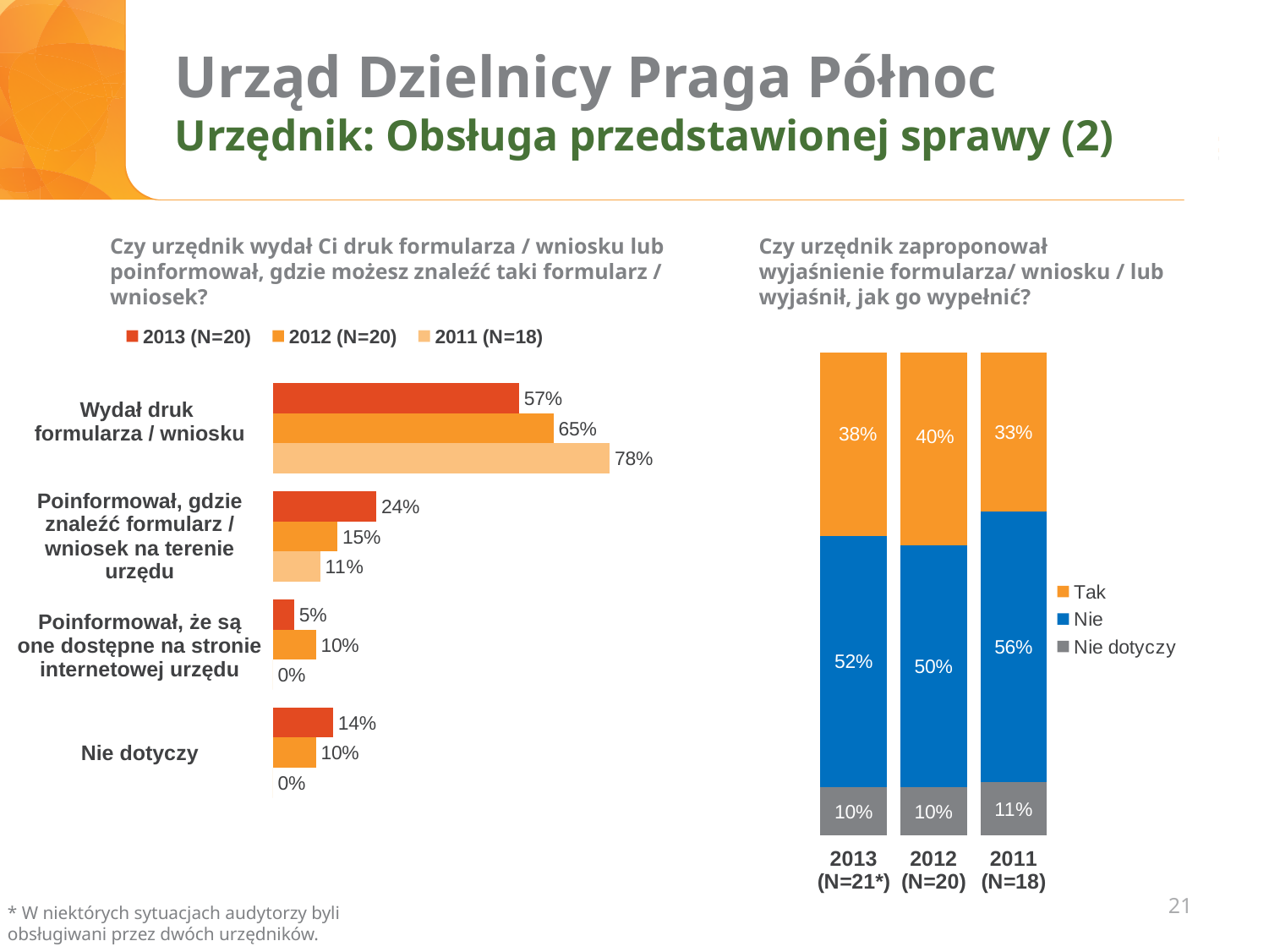
In the left chart, what is the 2012 (N=20) value for "Nie dotyczy"? 10% In the left chart, which category has the highest 2013 (N=20) value? Wydał druk formularza / wniosku In the left chart, what is the difference between the 2011 (N=18) and 2013 (N=20) values for "Wydał druk formularza / wniosku"? 21% In the right chart, what is the total of the 2013 (N=21*) bar? 100% In the right chart, which year has the lowest "Tak" share? 2011 (N=18) In the left chart, what is the 2011 (N=18) value for "Wydał druk formularza / wniosku"? 78% In the right chart, what is the "Nie" share for 2011 (N=18)? 56% In the left chart, how many categories are shown? 4 In the right chart, what is the "Tak" share for 2012 (N=20)? 40% In the left chart, what is the 2013 (N=20) value for "Poinformował, gdzie znaleźć formularz / wniosek na terenie urzędu"? 24% In the left chart, how many series does the legend list? 3 What kind of chart is the chart on the right? Stacked bar chart